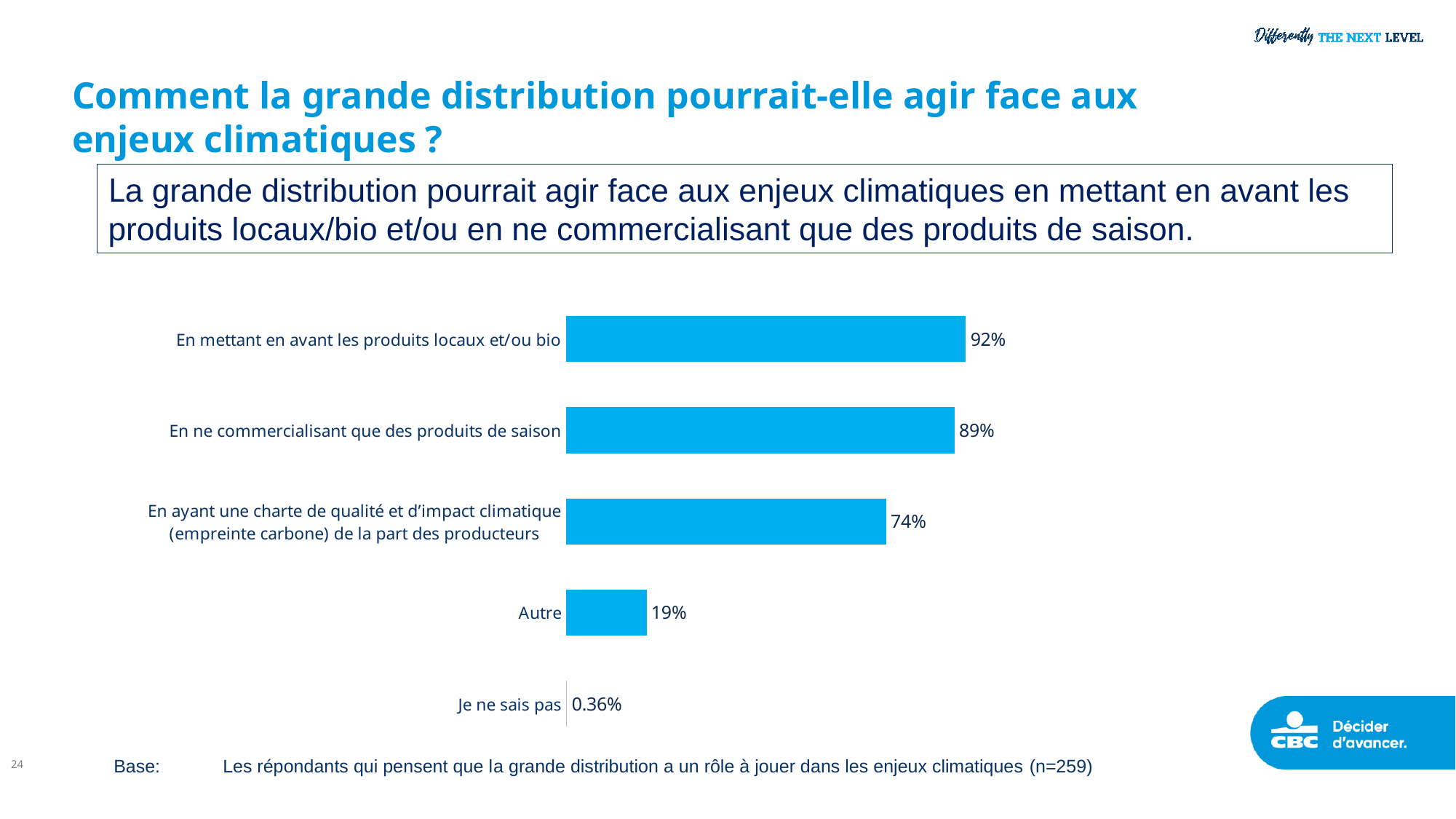
How many categories are shown in the chart? 5 What kind of chart is shown on the slide? Bar chart What is the difference between the values for "En mettant en avant les produits locaux et/ou bio" and "En ne commercialisant que des produits de saison"? 3% What is the value for "En ne commercialisant que des produits de saison"? 89% What is the value for "En mettant en avant les produits locaux et/ou bio"? 92% Which category has the lowest value? Je ne sais pas What is the value for "En ayant une charte de qualité et d'impact climatique (empreinte carbone) de la part des producteurs"? 74% Which category has the highest value? En mettant en avant les produits locaux et/ou bio What is the difference between the values for "En ne commercialisant que des produits de saison" and "Autre"? 70% Which is larger: the value for "En ayant une charte de qualité et d'impact climatique (empreinte carbone) de la part des producteurs" or the value for "Autre"? En ayant une charte de qualité et d'impact climatique (empreinte carbone) de la part des producteurs What is the value for "Autre"? 19% What is the value for "Je ne sais pas"? 0.36%